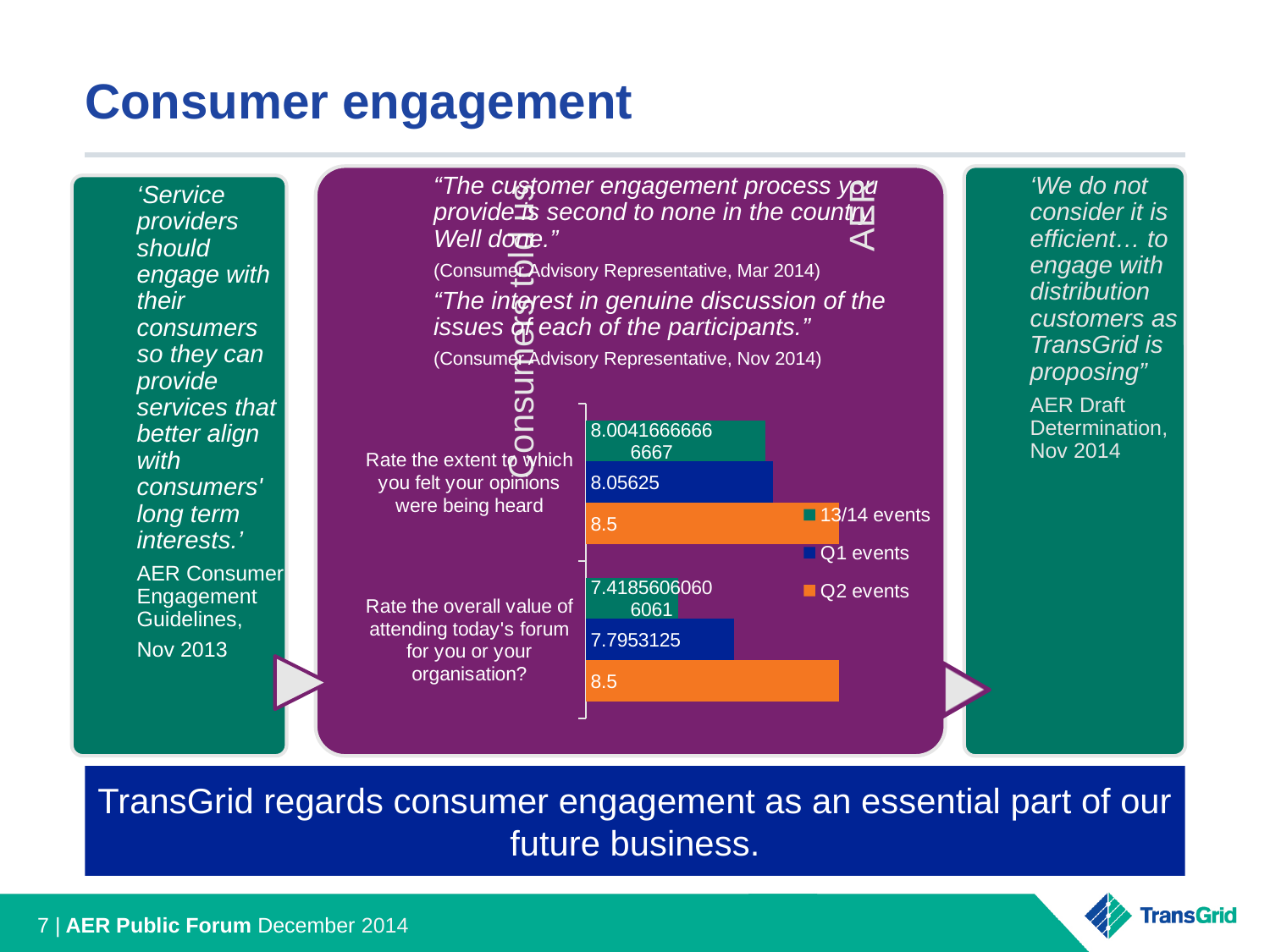
How many series does the chart legend list? 3 How many categories (questions) are plotted on the chart? 2 What is the difference between the Q2 events value and the Q1 events value for 'Rate the overall value of attending today's forum for you or your organisation?'? 0.7046875 Which legend entry is shown in orange? Q2 events Which series has the highest value for 'Rate the overall value of attending today's forum for you or your organisation?'? Q2 events What is the Q1 events value for 'Rate the extent to which you felt your opinions were being heard'? 8.05625 For 'Rate the overall value of attending today's forum for you or your organisation?', which is larger: the Q1 events value or the Q2 events value? Q2 events What is the Q1 events value for 'Rate the overall value of attending today's forum for you or your organisation?'? 7.7953125 What is the Q2 events value for 'Rate the extent to which you felt your opinions were being heard'? 8.5 What is the Q2 events value for 'Rate the overall value of attending today's forum for you or your organisation?'? 8.5 What kind of chart is shown on the slide? bar chart Which series has the lowest value for 'Rate the overall value of attending today's forum for you or your organisation?'? 13/14 events